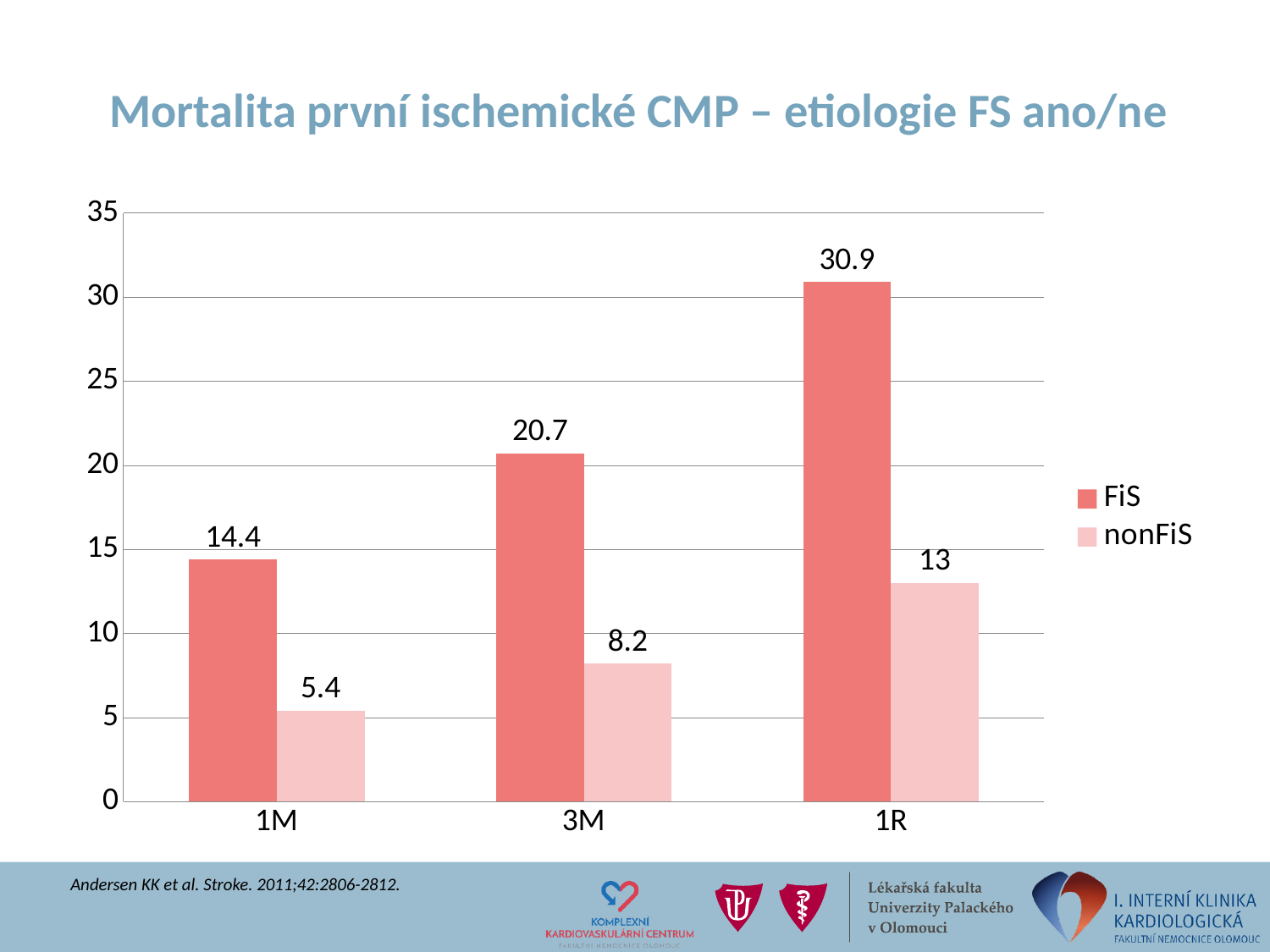
How many series does the legend list? 2 What kind of chart is shown on the slide? bar chart Which category has the lowest nonFiS value? 1M What is the FiS value at 1R? 30.9 What is the nonFiS value at 1R? 13 How many categories are shown on the x axis? 3 Do the FiS values rise or fall from 1M to 1R? rise What is the nonFiS value at 3M? 8.2 Which is larger at 1M, the FiS value or the nonFiS value? FiS What is the FiS value at 1M? 14.4 Which category has the highest FiS value? 1R What is the difference between the FiS and nonFiS values at 3M? 12.5